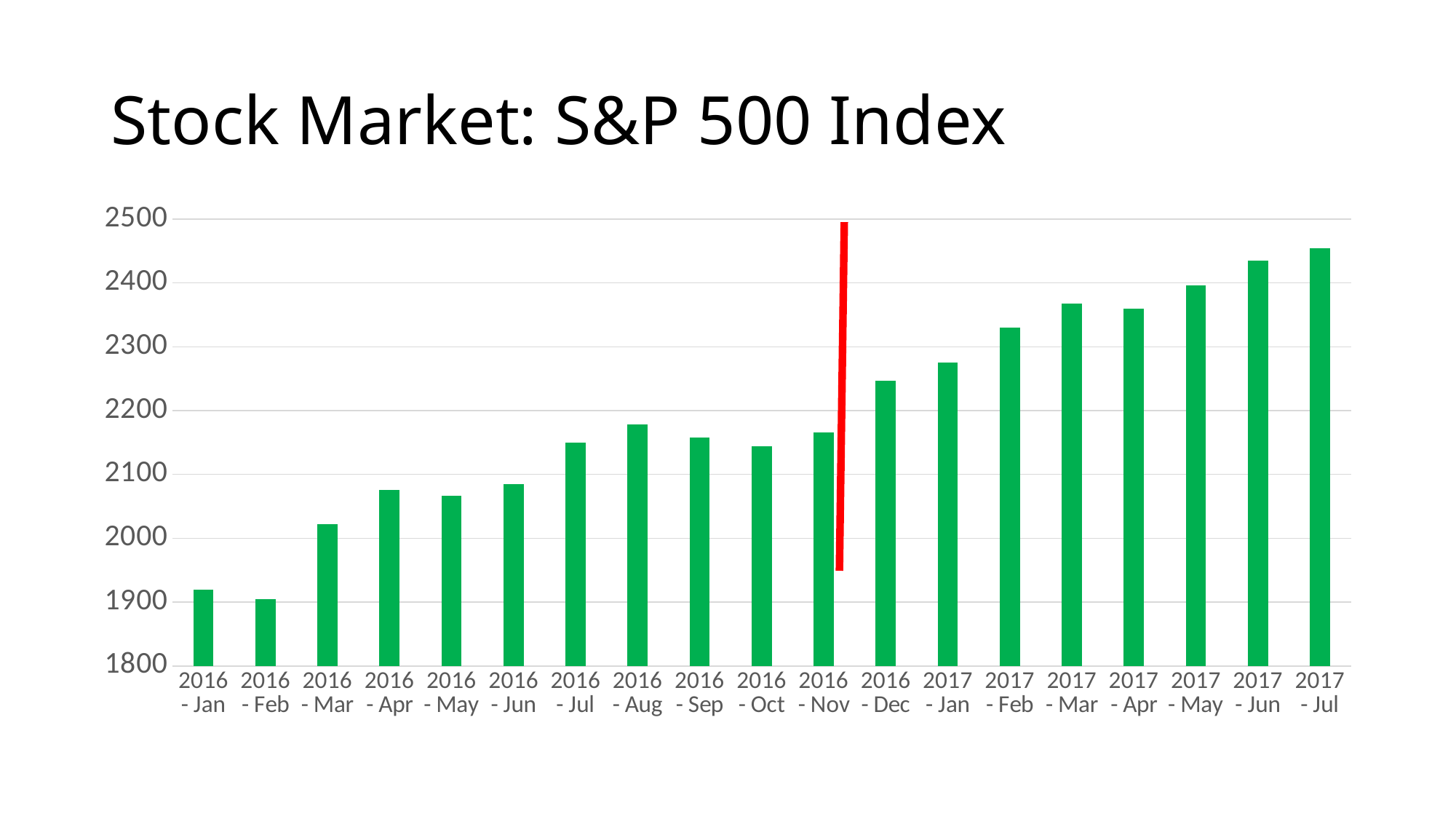
Which month has the lowest S&P 500 value? 2016 - Feb Which is larger, the value for 2016 - Aug or 2016 - Sep? 2016 - Aug Between which two months is the red vertical line drawn? 2016 - Nov and 2016 - Dec Do the S&P 500 values generally rise or fall from 2016 - Jan to 2017 - Jul? rise Is the value for 2016 - Mar greater or less than 2000? greater How many months (bars) are plotted in the chart? 19 What kind of chart is shown on the slide? bar chart What is the title of the chart? Stock Market: S&P 500 Index Is the value for 2017 - Jun greater or less than 2400? greater Is the value for 2016 - Dec greater or less than 2200? greater Which month has the highest S&P 500 value? 2017 - Jul